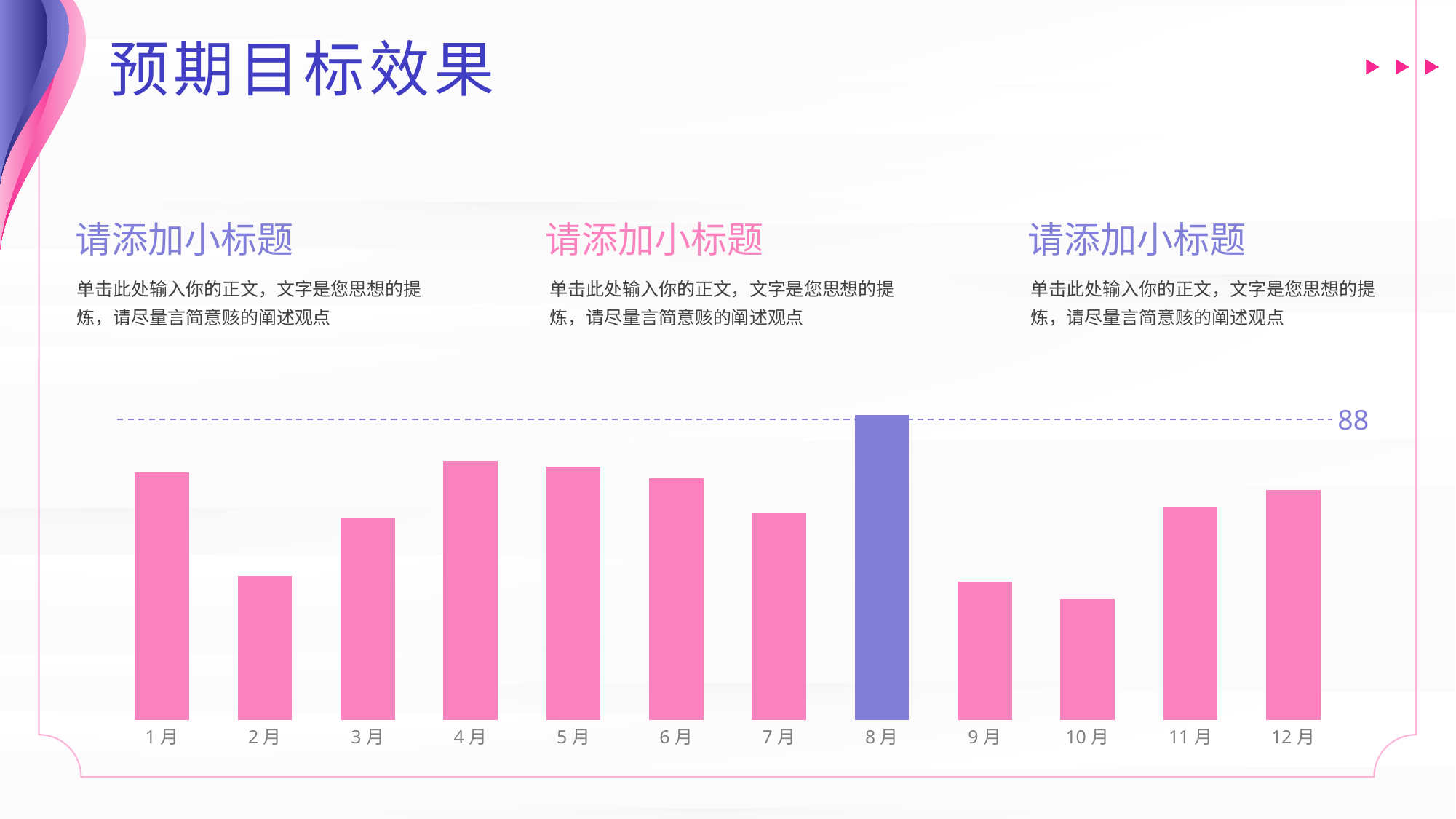
Which is larger, the value for 12月 or the value for 11月? 12月 What is the title of the slide containing the chart? 预期目标效果 Is the value for 1月 greater or less than 88? less Which is larger, the value for 6月 or the value for 7月? 6月 Which month's bar is coloured purple instead of pink? 8月 What kind of chart is shown on the slide? bar chart How many months are shown on the x axis of the chart? 12 Which month has the lowest bar in the chart? 10月 Which is larger, the value for 1月 or the value for 2月? 1月 Which month has the highest bar in the chart? 8月 What value is marked by the dashed line at the top of the 8月 bar? 88